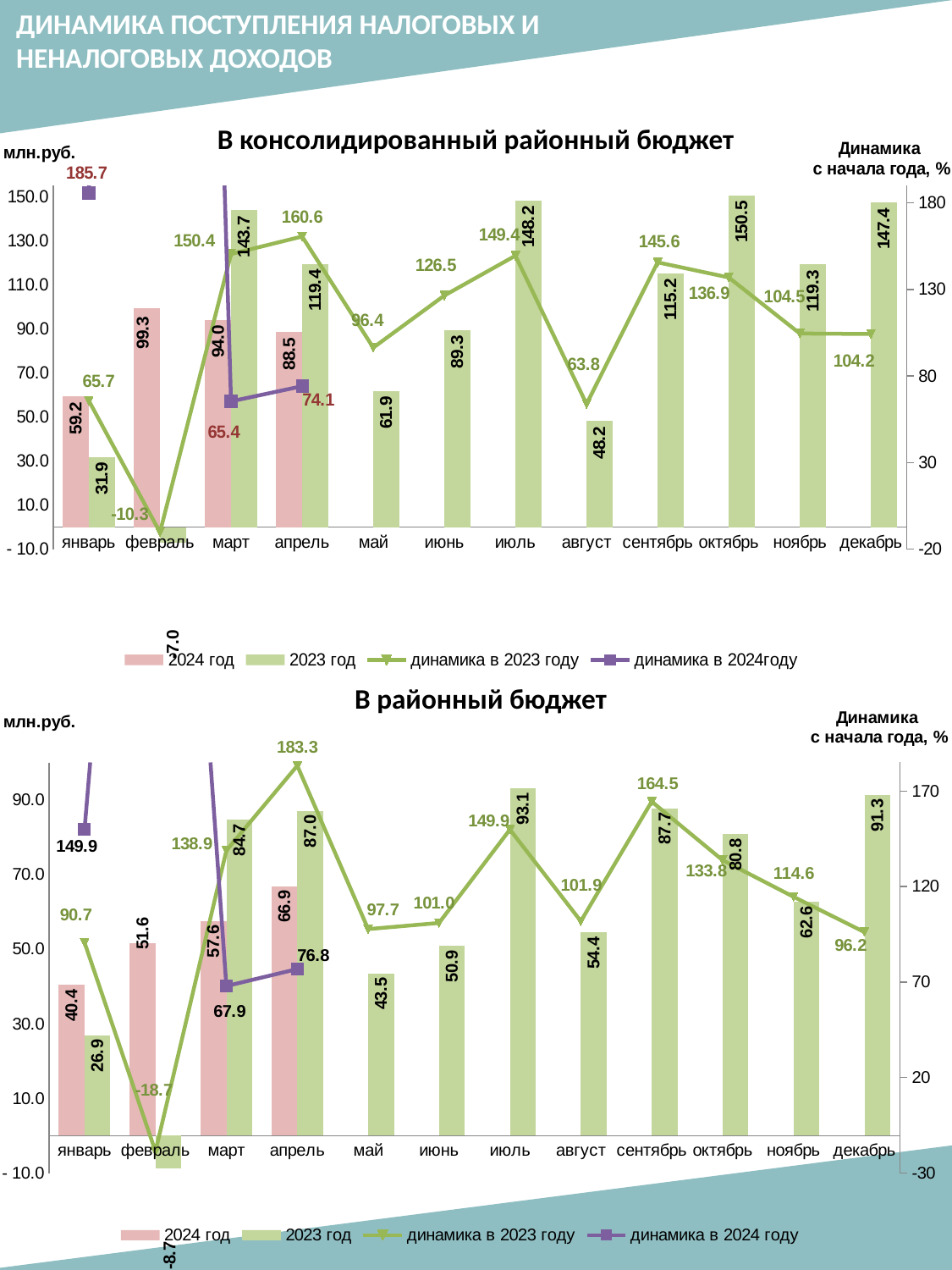
On the chart 'В консолидированный районный бюджет', what is the value of 'динамика в 2023 году' for апрель? 160.6 On the chart 'В консолидированный районный бюджет', what is the difference between the 2024 год and 2023 год bars for январь? 27.3 On the chart 'В районный бюджет', which month has the highest value of 'динамика в 2023 году'? апрель On the chart 'В районный бюджет', what is the difference between the 2023 год bars for июль and август? 38.7 On the chart 'В консолидированный районный бюджет', how many series does the legend list? 4 On the chart 'В районный бюджет', which is larger for март: the 2024 год bar or the 2023 год bar? 2023 год On the chart 'В районный бюджет', how many months are shown on the x axis? 12 On the chart 'В консолидированный районный бюджет', which month has the lowest 2023 год bar? февраль On the chart 'В консолидированный районный бюджет', what is the value of the 2023 год bar for июль? 148.2 On the chart 'В районный бюджет', what is the value of 'динамика в 2024 году' for январь? 149.9 On the chart 'В консолидированный районный бюджет', what is the value of the 2024 год bar for февраль? 99.3 On the chart 'В районный бюджет', what is the value of the 2023 год bar for декабрь? 91.3